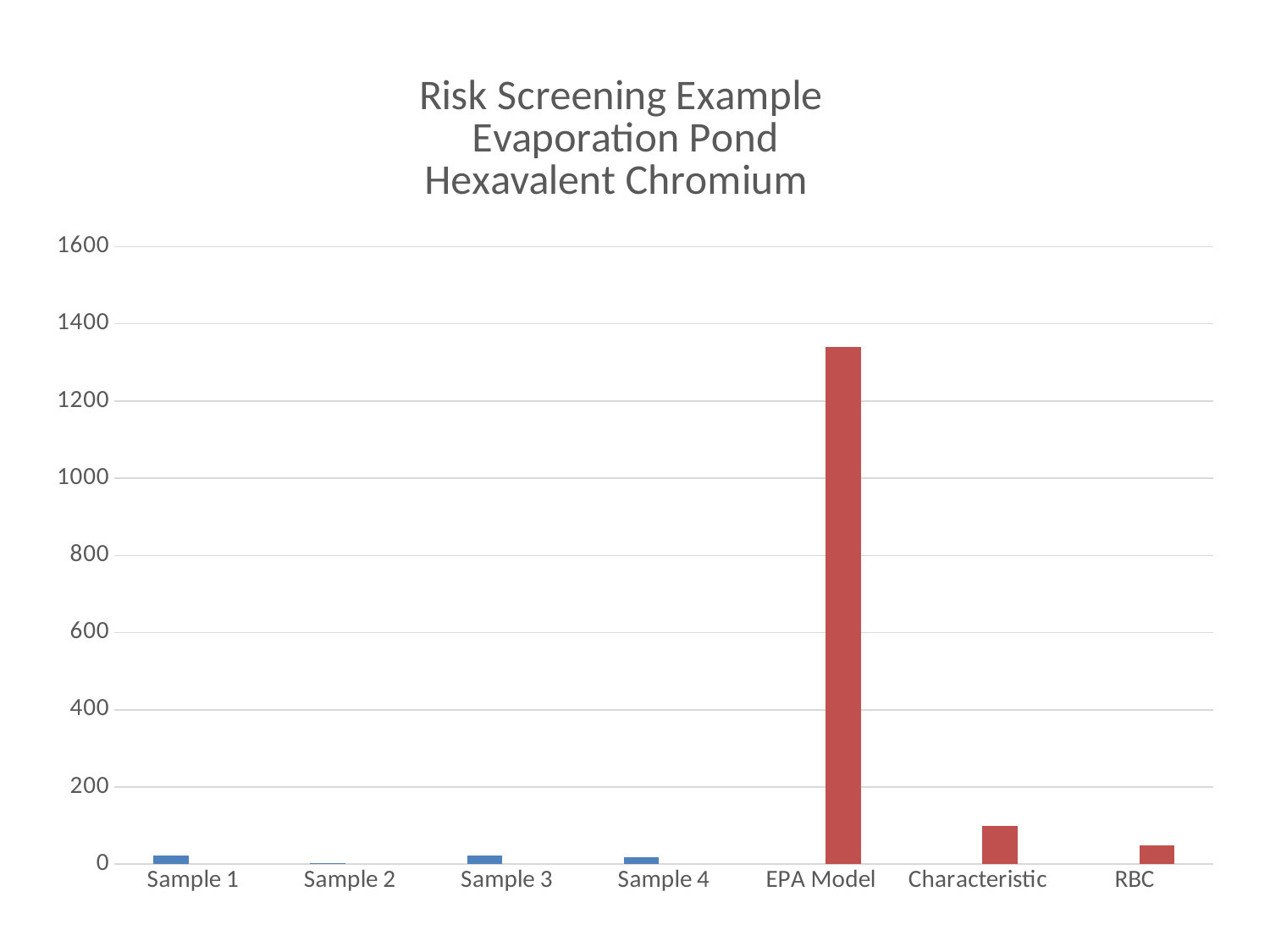
How many categories are plotted along the x axis? 7 Which is larger, the value for Sample 1 or the value for Sample 2? Sample 1 Which category has the highest value? EPA Model Which is larger, the value for EPA Model or the value for Characteristic? EPA Model Is the value for RBC greater or less than 200? less Which category has the lowest value? Sample 2 Is the value for EPA Model greater or less than 1200? greater What is the third line of the chart title? Hexavalent Chromium Which is larger, the value for Characteristic or the value for RBC? Characteristic Is the value for EPA Model greater or less than 1400? less What kind of chart is shown on the slide? bar chart